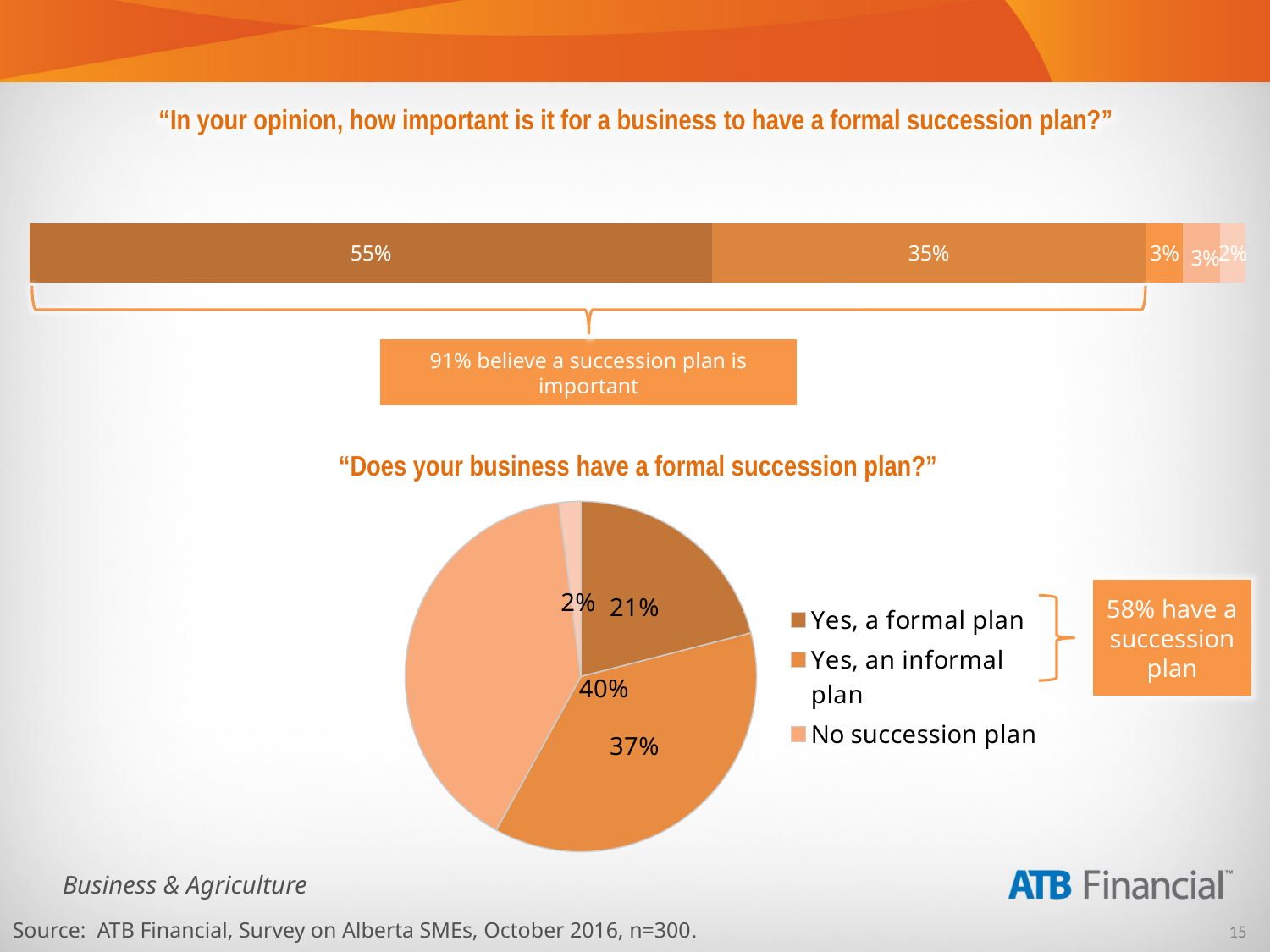
What kind of chart is used for "Does your business have a formal succession plan?"? Pie chart In the pie chart titled "Does your business have a formal succession plan?", which legend category has the smallest share? Yes, a formal plan How many segments does the stacked bar chart at the top of the slide have? 5 In the pie chart titled "Does your business have a formal succession plan?", which legend category has the largest share? No succession plan In the pie chart titled "Does your business have a formal succession plan?", what percentage of businesses have an informal plan? 37% In the pie chart titled "Does your business have a formal succession plan?", what is the difference in percentage points between "No succession plan" and "Yes, a formal plan"? 19 How many entries does the legend of the pie chart titled "Does your business have a formal succession plan?" list? 3 What kind of chart is used for "In your opinion, how important is it for a business to have a formal succession plan?"? Stacked bar chart In the pie chart titled "Does your business have a formal succession plan?", which is larger: "Yes, an informal plan" or "Yes, a formal plan"? Yes, an informal plan In the pie chart titled "Does your business have a formal succession plan?", what percentage of businesses have a formal plan? 21% In the stacked bar chart at the top of the slide, what is the value of the largest segment? 55% In the pie chart titled "Does your business have a formal succession plan?", what percentage of businesses have no succession plan? 40%